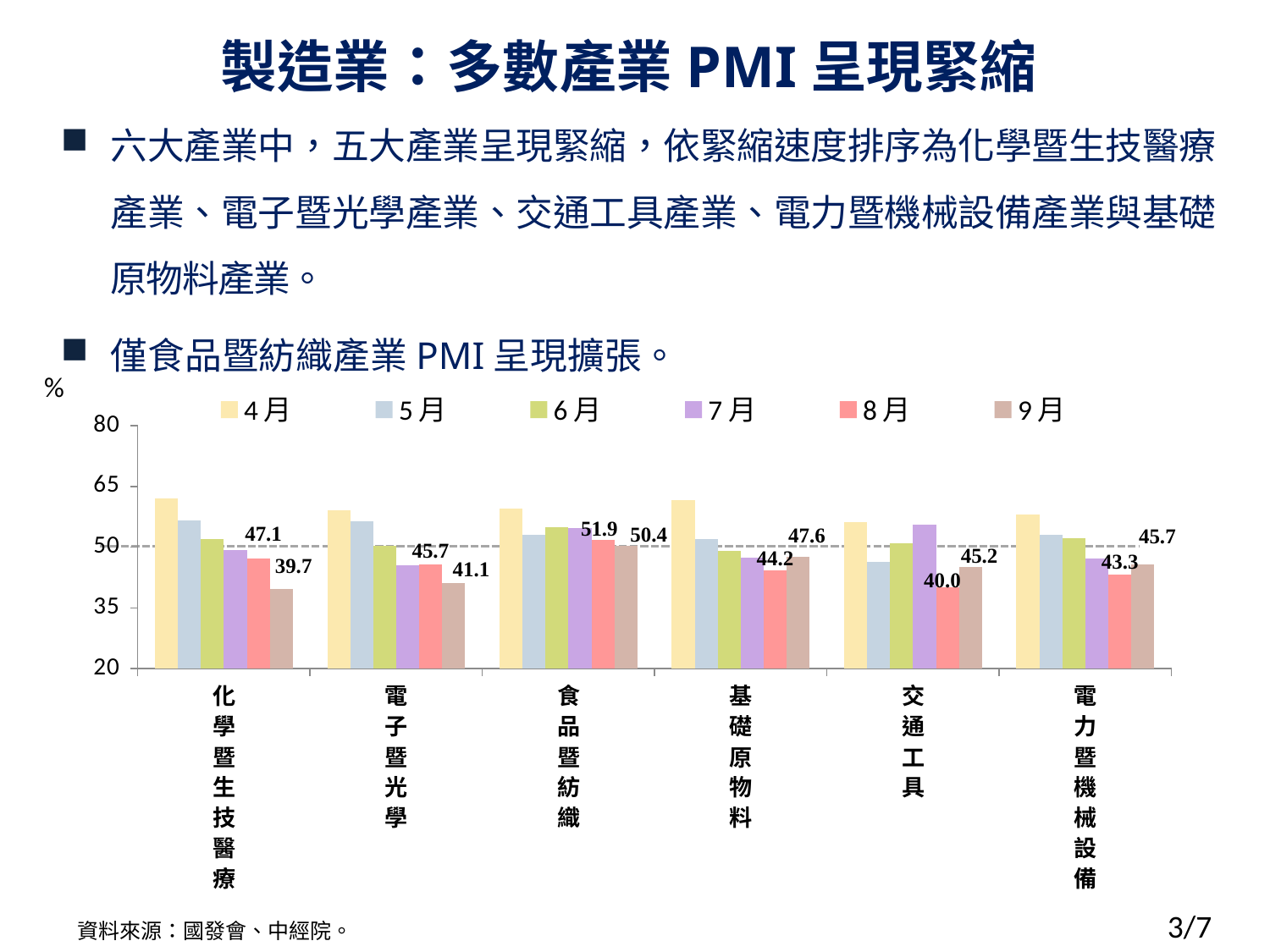
What is the 9月 value for 化學暨生技醫療? 39.7 How many industries are shown on the x axis? 6 Do the values for 化學暨生技醫療 rise or fall from 4月 to 9月? fall Which industry has the lowest 9月 value? 化學暨生技醫療 What is the 9月 value for 電力暨機械設備? 45.7 Which industry has the highest 9月 value? 食品暨紡織 What is the 8月 value for 食品暨紡織? 51.9 What is the difference between the 8月 and 9月 values for 化學暨生技醫療? 7.4 Which is larger for 基礎原物料, the 8月 value or the 9月 value? 9月 How many series does the legend list? 6 Is the 4月 value for 電子暨光學 greater or less than 50? greater What is the 8月 value for 交通工具? 40.0